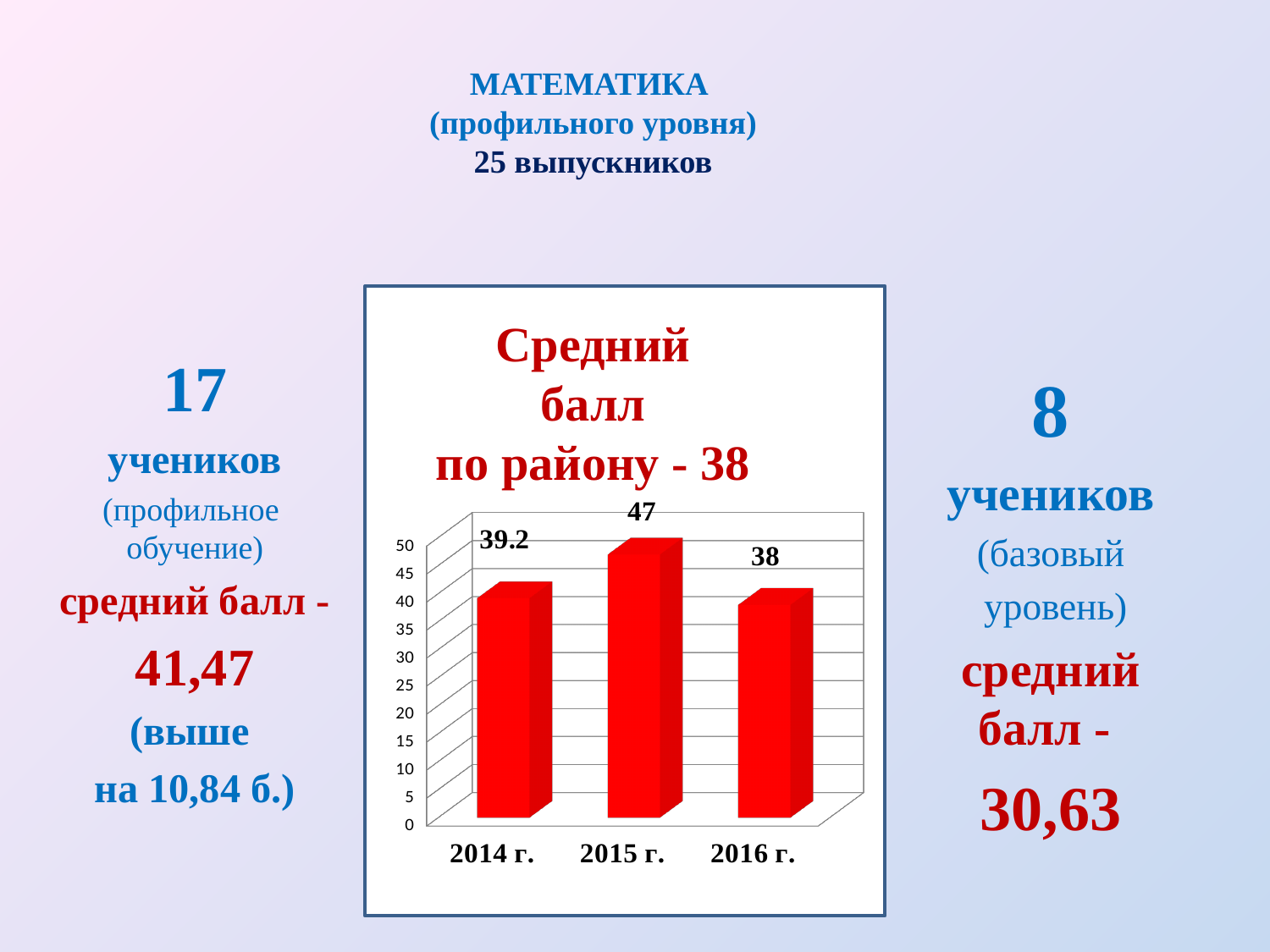
What is the difference between the values for 2015 г. and 2016 г.? 9 What kind of chart is shown on the slide? bar chart Which is larger, the value for 2014 г. or the value for 2016 г.? 2014 г. Is the value for 2015 г. greater or less than 45? greater Which year has the highest value? 2015 г. Which year has the lowest value? 2016 г. What is the difference between the values for 2015 г. and 2014 г.? 7.8 What is the value for 2016 г.? 38 What is the value for 2015 г.? 47 What is the title of the chart? Средний балл по району - 38 How many years are shown on the chart? 3 What is the value for 2014 г.? 39.2